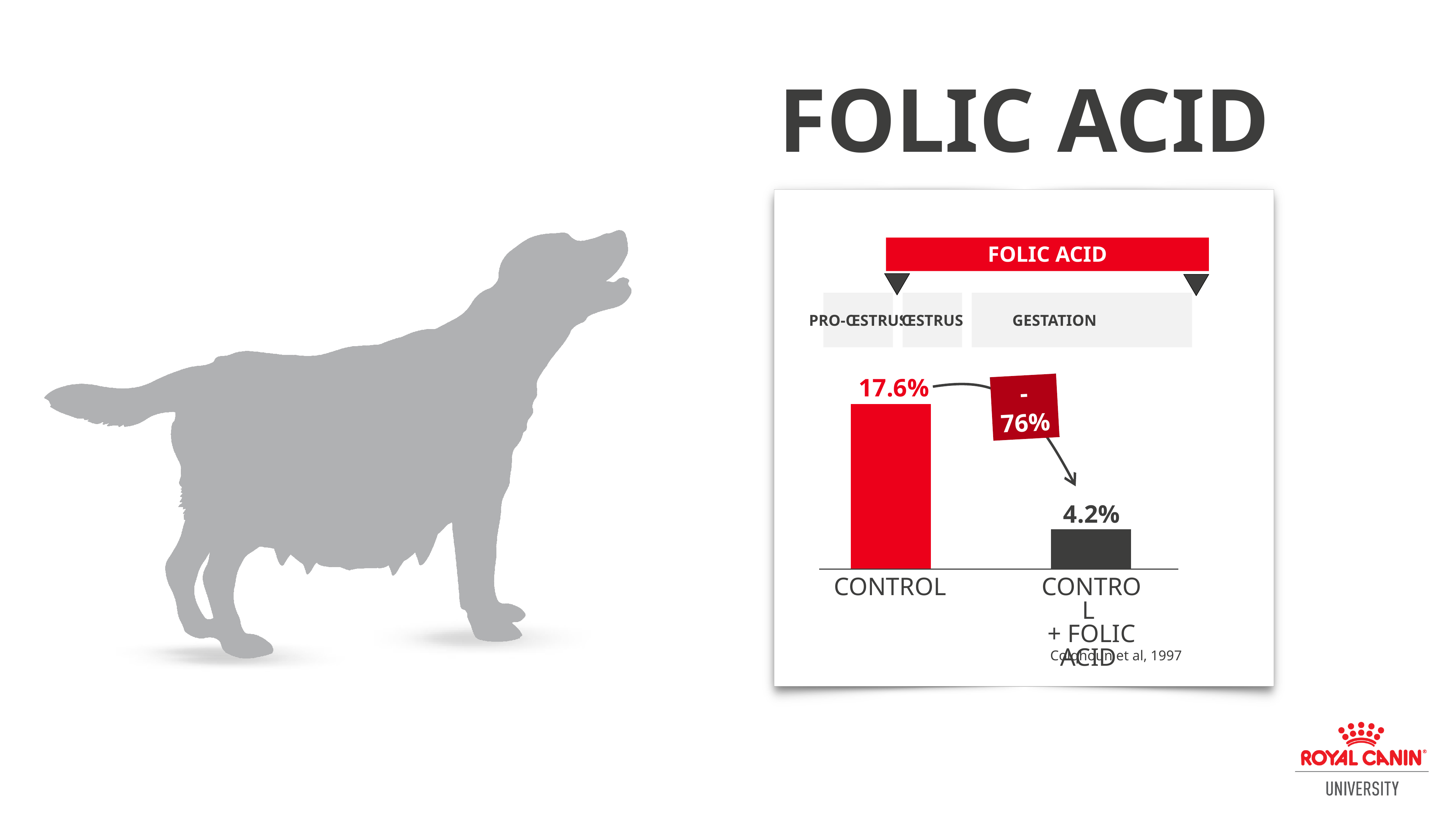
What is the difference between the CONTROL value and the CONTROL + FOLIC ACID value? 13.4% Which is larger, the value for CONTROL or the value for CONTROL + FOLIC ACID? CONTROL Which category has the highest value? CONTROL What is the value for CONTROL + FOLIC ACID? 4.2% What colour is the CONTROL bar? Red How many bars are plotted in the chart? 2 What is the value for CONTROL? 17.6% Which category has the lowest value? CONTROL + FOLIC ACID What percentage change is shown in the callout between the two bars? -76% What kind of chart is shown on the slide? Bar chart